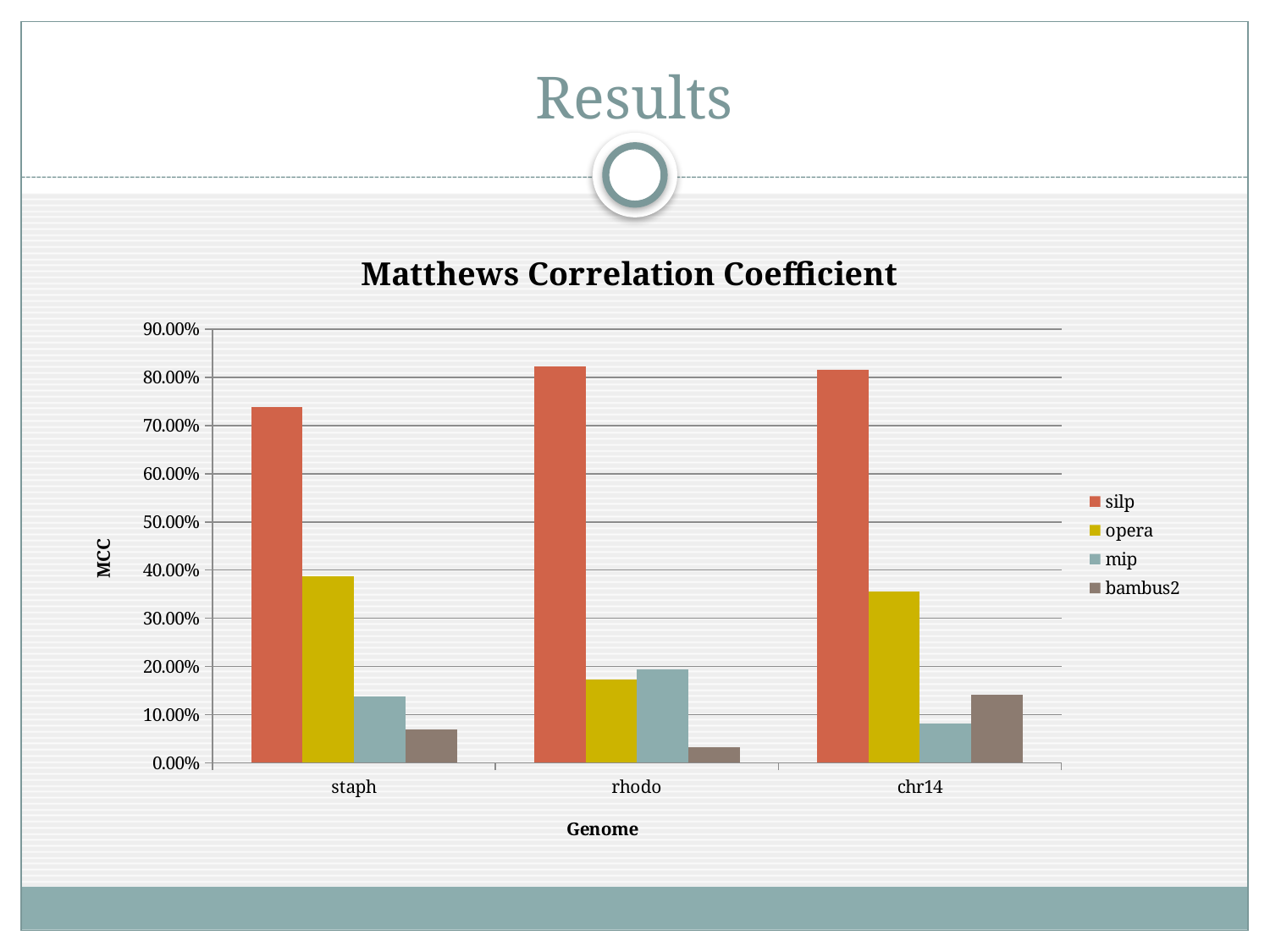
How many series does the legend list? 4 How many genome categories are shown on the x axis? 3 Which is larger for the chr14 genome, the value for opera or the value for bambus2? opera Which series has the highest value for the staph genome? silp What kind of chart is shown on the slide? bar chart Which is larger, the value for silp on staph or the value for silp on rhodo? silp on rhodo Is the value for silp on the rhodo genome greater or less than 80.00%? greater Which series has the lowest value for the chr14 genome? mip Which series has the lowest value for the rhodo genome? bambus2 What is the title of the chart? Matthews Correlation Coefficient Is the value for silp on the staph genome greater or less than 70.00%? greater Is the value for opera on the rhodo genome greater or less than 20.00%? less